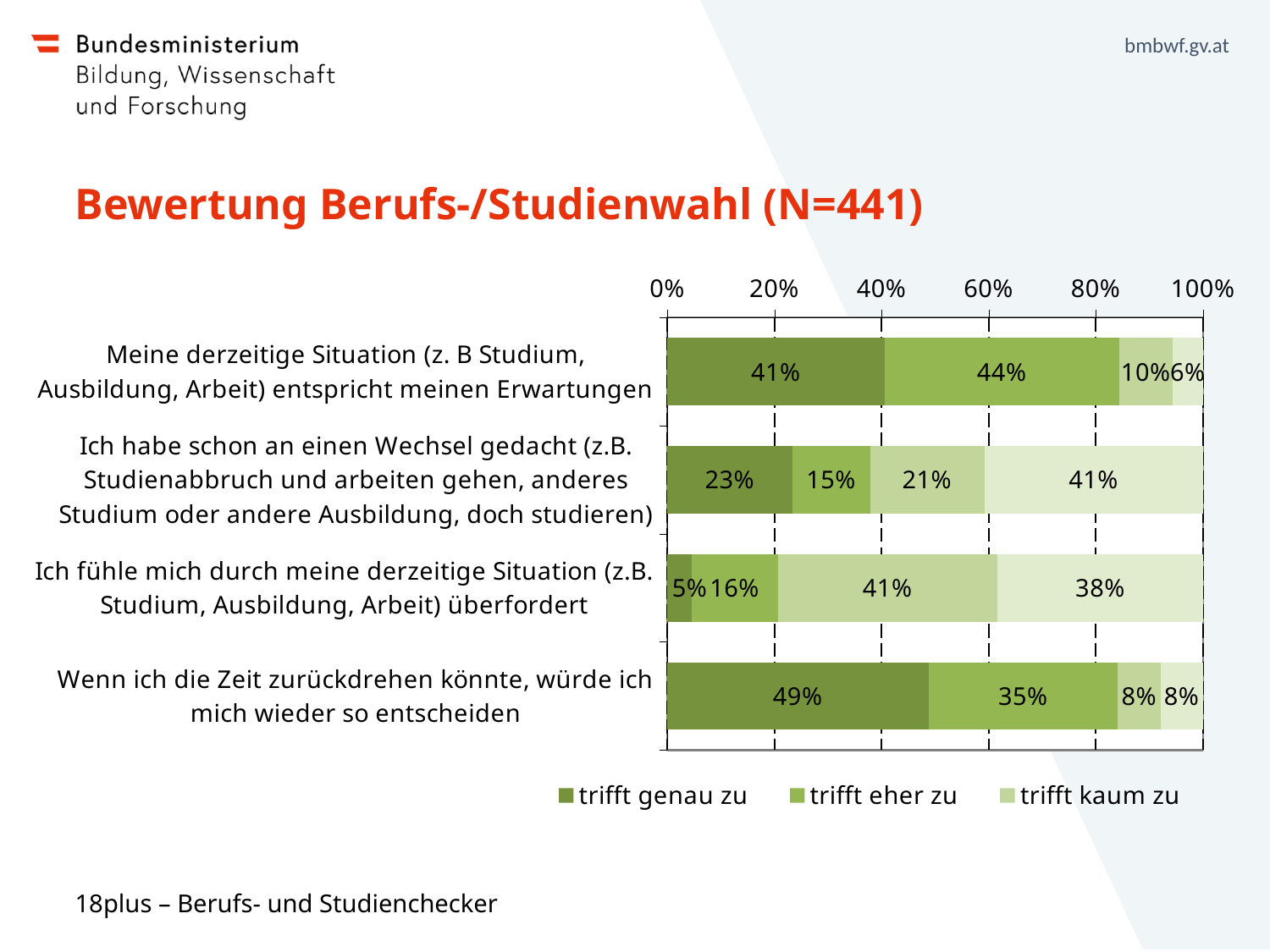
What kind of chart is shown on the slide? Stacked horizontal bar chart Which statement has the lowest "trifft genau zu" value? Ich fühle mich durch meine derzeitige Situation (z.B. Studium, Ausbildung, Arbeit) überfordert What is the title of the chart on the slide? Bewertung Berufs-/Studienwahl (N=441) How many statements (categories) are shown in the chart? 4 What is the "trifft kaum zu" value for "Ich habe schon an einen Wechsel gedacht ..."? 21% How many series does the legend list? 3 What is the "trifft genau zu" value for "Ich fühle mich durch meine derzeitige Situation (z.B. Studium, Ausbildung, Arbeit) überfordert"? 5% Which statement has the highest "trifft genau zu" value? Wenn ich die Zeit zurückdrehen könnte, würde ich mich wieder so entscheiden What percentage of respondents answered "trifft genau zu" for "Wenn ich die Zeit zurückdrehen könnte, würde ich mich wieder so entscheiden"? 49% Which is larger: the "trifft eher zu" value for "Ich habe schon an einen Wechsel gedacht ..." or for "Ich fühle mich ... überfordert"? Ich fühle mich ... überfordert (16%) What is the difference between the "trifft genau zu" values for "Wenn ich die Zeit zurückdrehen könnte ..." and "Meine derzeitige Situation ... entspricht meinen Erwartungen"? 8% What is the "trifft eher zu" value for "Meine derzeitige Situation (z. B Studium, Ausbildung, Arbeit) entspricht meinen Erwartungen"? 44%